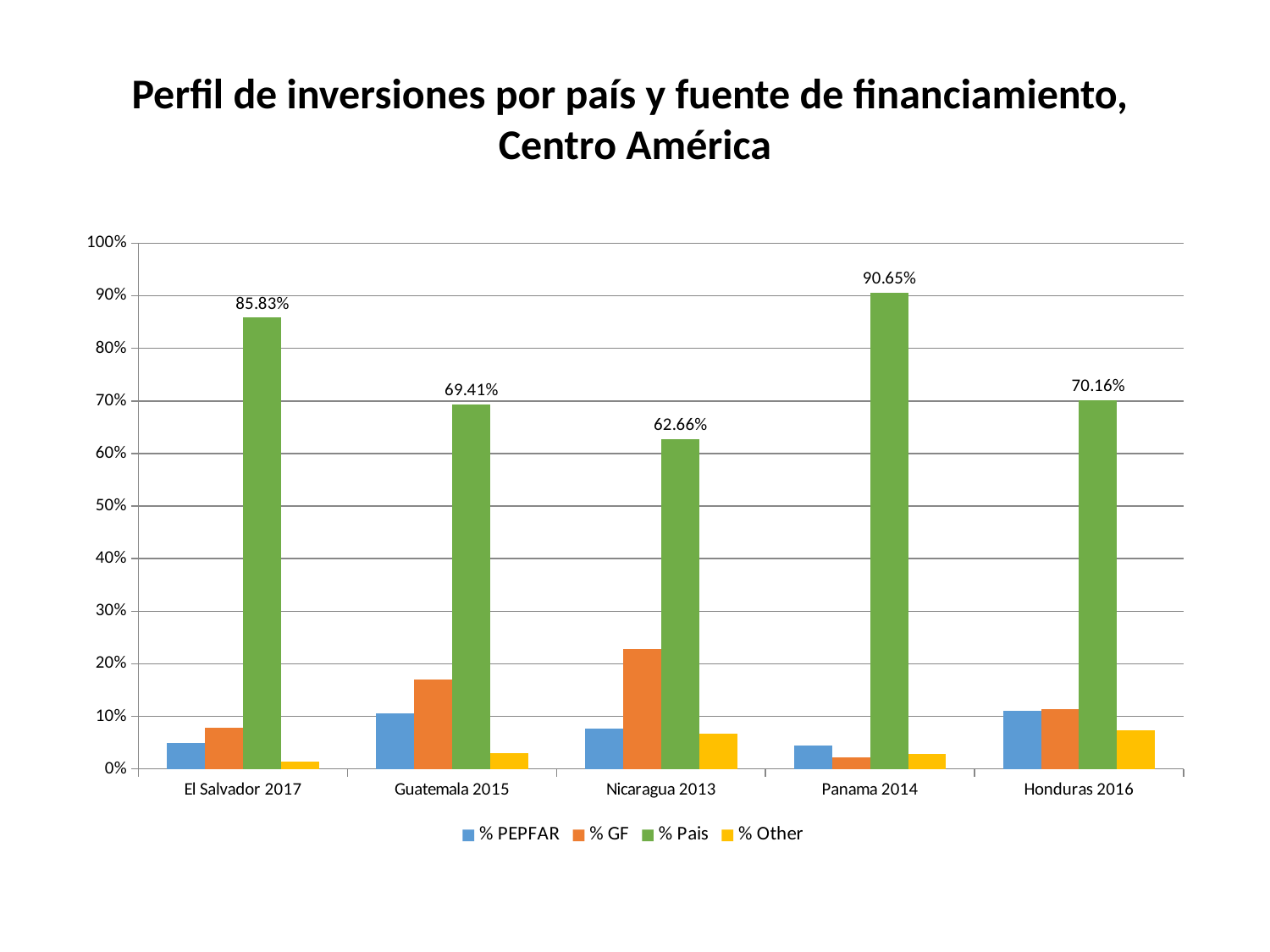
How many series does the legend list? 4 Is the % PEPFAR value for Panama 2014 greater or less than 10%? less What is the difference between the % Pais values for Panama 2014 and Nicaragua 2013? 27.99% How many countries are shown on the x axis? 5 What is the % Pais value for Nicaragua 2013? 62.66% Which is larger, the % Pais value for Guatemala 2015 or for Honduras 2016? Honduras 2016 Is the % GF value for Nicaragua 2013 greater or less than 20%? greater What is the % Pais value for Panama 2014? 90.65% Which country has the highest % Pais value? Panama 2014 Which country has the lowest % Pais value? Nicaragua 2013 What kind of chart is shown on the slide? Bar chart What is the % Pais value for El Salvador 2017? 85.83%